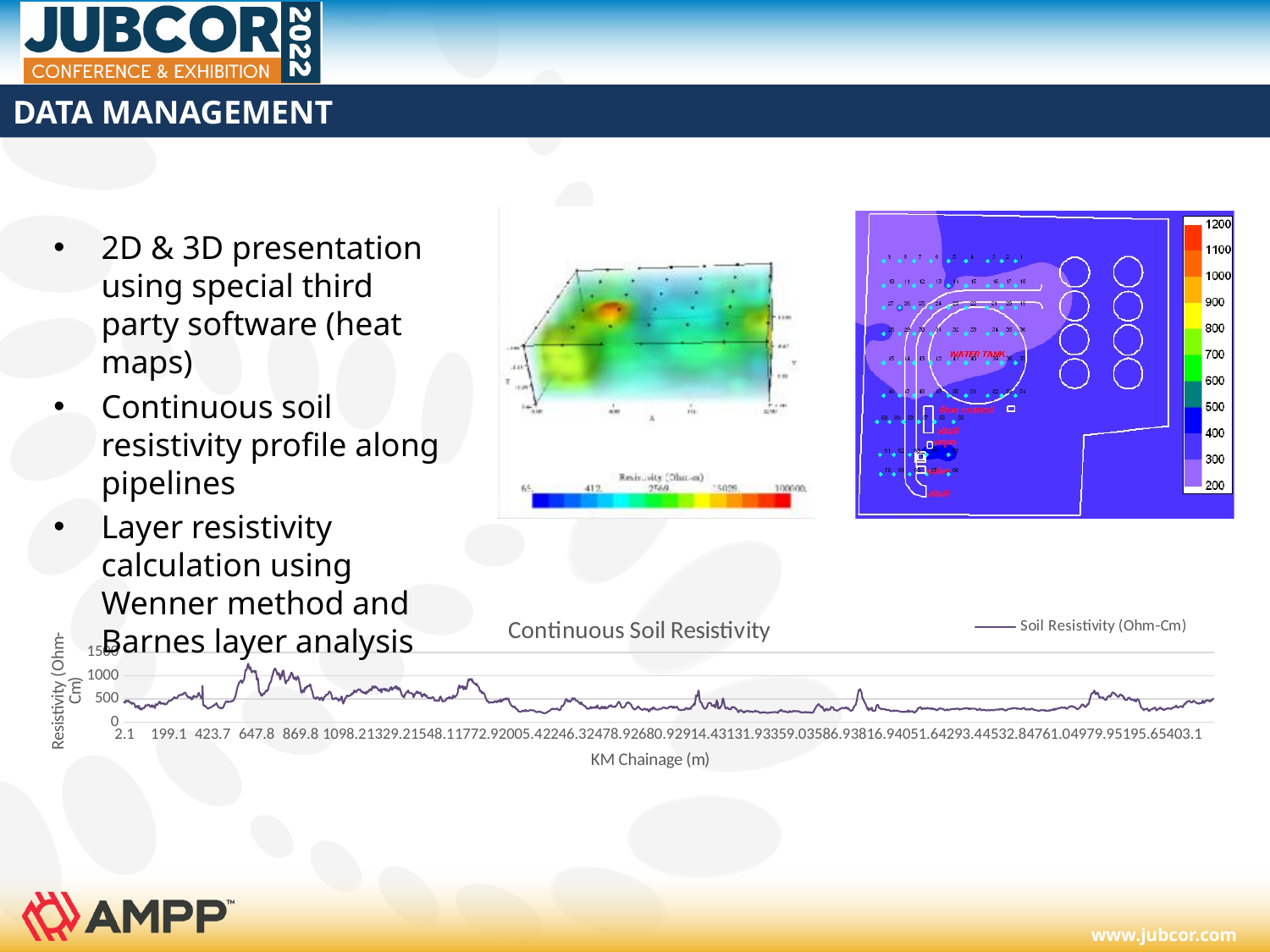
In the 'Continuous Soil Resistivity' chart, is the value at KM Chainage 3131.9 greater or less than 1000? less In the 'Continuous Soil Resistivity' chart, is the value at KM Chainage 647.8 larger or smaller than the value at KM Chainage 2.1? larger In the 'Continuous Soil Resistivity' chart, is the value at KM Chainage 2.1 greater or less than 500? less What kind of chart is the 'Continuous Soil Resistivity' chart at the bottom of the slide? line chart In the 'Continuous Soil Resistivity' chart, is the highest peak of the line greater or less than 1500? less How many series does the legend of the 'Continuous Soil Resistivity' chart list? 1 What series name is shown in the legend of the 'Continuous Soil Resistivity' chart? Soil Resistivity (Ohm-Cm) In the 'Continuous Soil Resistivity' chart, near which x-axis label does the line reach its highest peak? 647.8 What is the title of the line chart at the bottom of the slide? Continuous Soil Resistivity